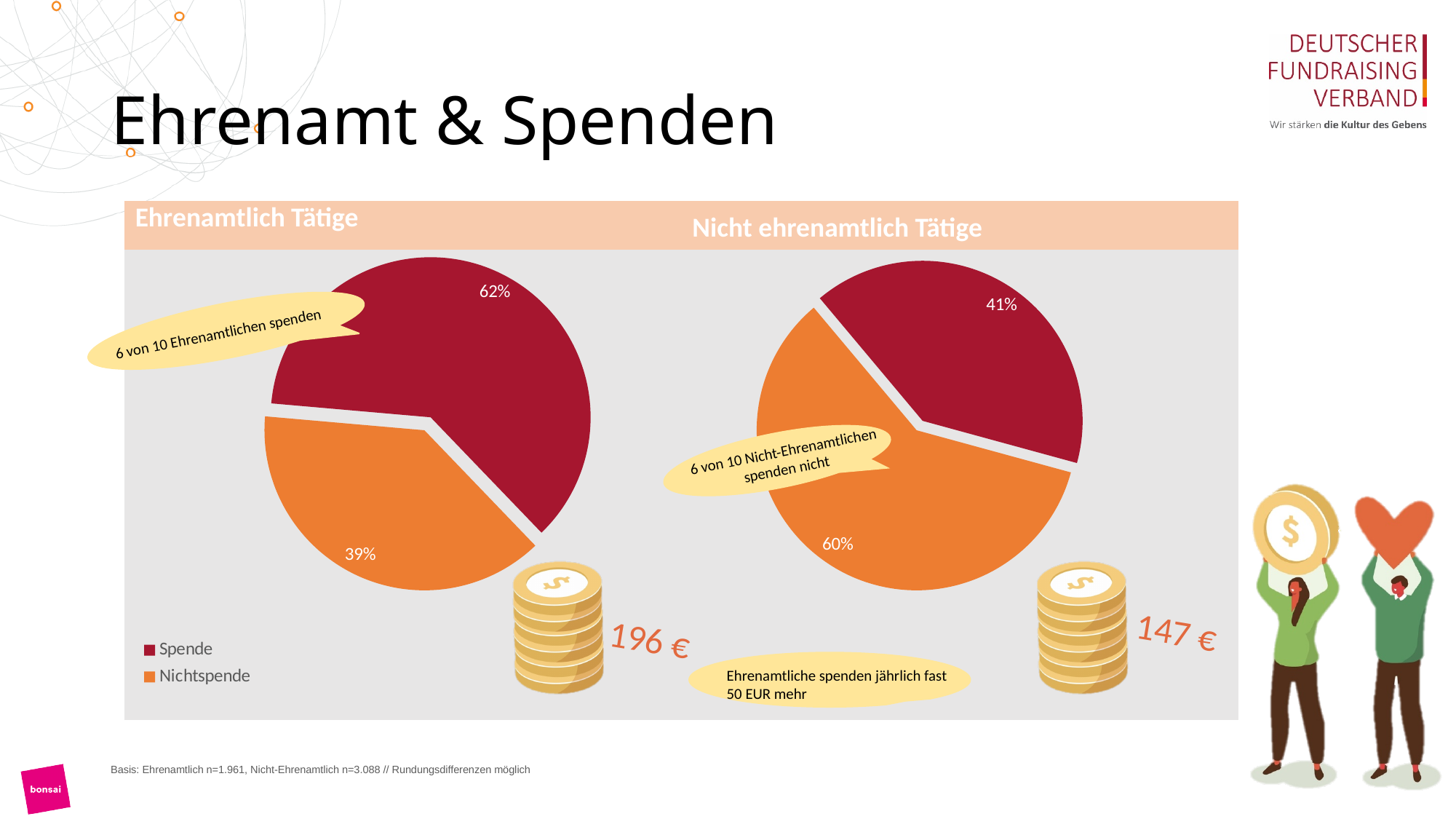
In the "Ehrenamtlich Tätige" pie chart, how many percentage points larger is Spende than Nichtspende? 23 In the "Nicht ehrenamtlich Tätige" pie chart, which slice is the smallest? Spende In the "Ehrenamtlich Tätige" pie chart, what is the share for Spende? 62% How many entries does the legend list for the pie charts? 2 What type of chart is used for "Ehrenamtlich Tätige"? pie chart How many slices does the "Nicht ehrenamtlich Tätige" pie chart have? 2 In the "Ehrenamtlich Tätige" pie chart, what is the share for Nichtspende? 39% Which is larger: the Spende share for "Ehrenamtlich Tätige" or the Spende share for "Nicht ehrenamtlich Tätige"? Ehrenamtlich Tätige In the "Nicht ehrenamtlich Tätige" pie chart, what is the share for Spende? 41% In the "Ehrenamtlich Tätige" pie chart, which slice is the largest? Spende Which colour represents Nichtspende in the pie charts? orange In the "Nicht ehrenamtlich Tätige" pie chart, what is the share for Nichtspende? 60%